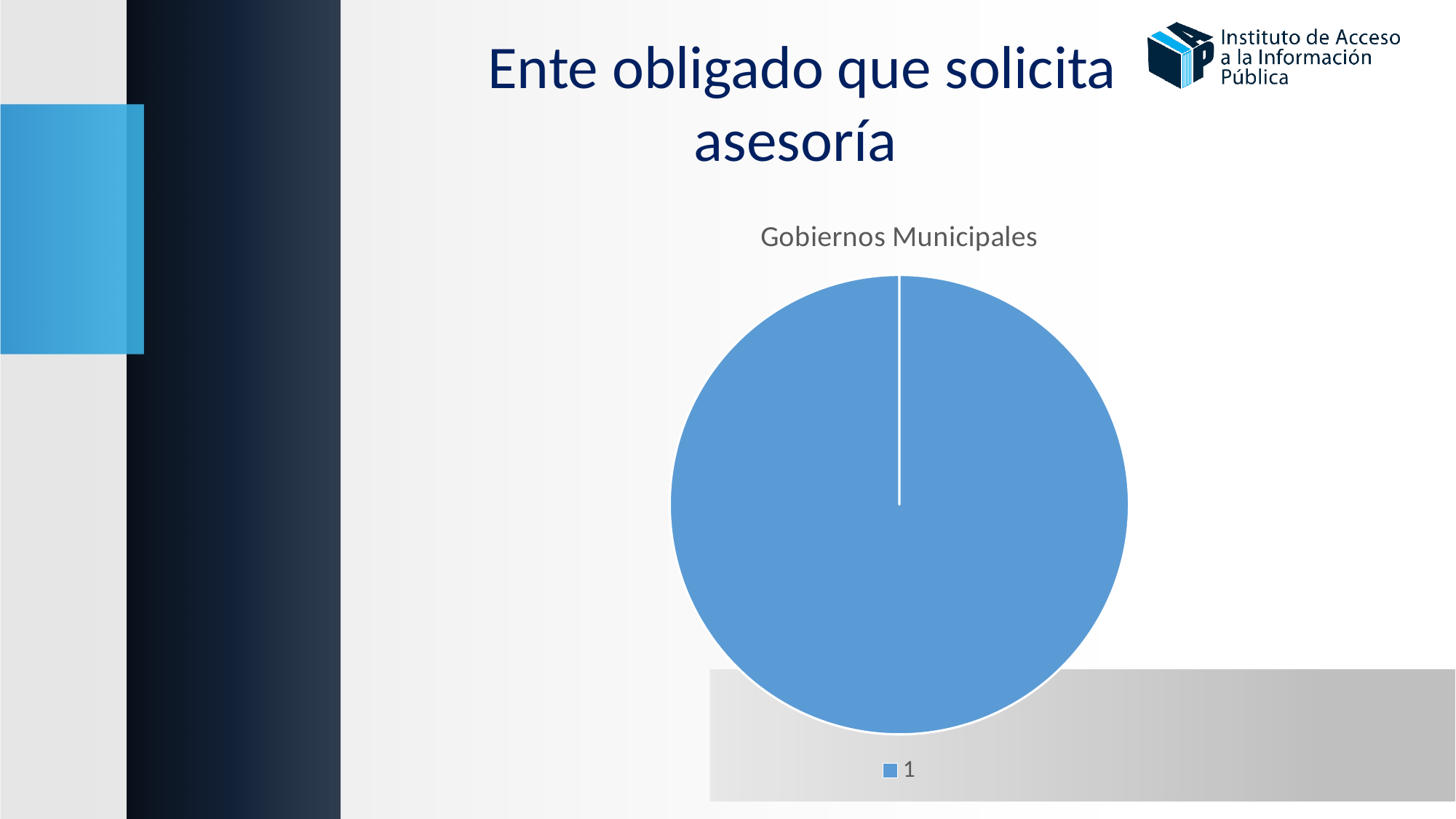
What share of the pie does the single slice occupy? 100% What is the title of the pie chart? Gobiernos Municipales How many entries does the legend of the pie chart list? 1 How many slices does the pie chart have? 1 What kind of chart is shown on the slide? Pie chart What label appears in the legend of the pie chart? 1